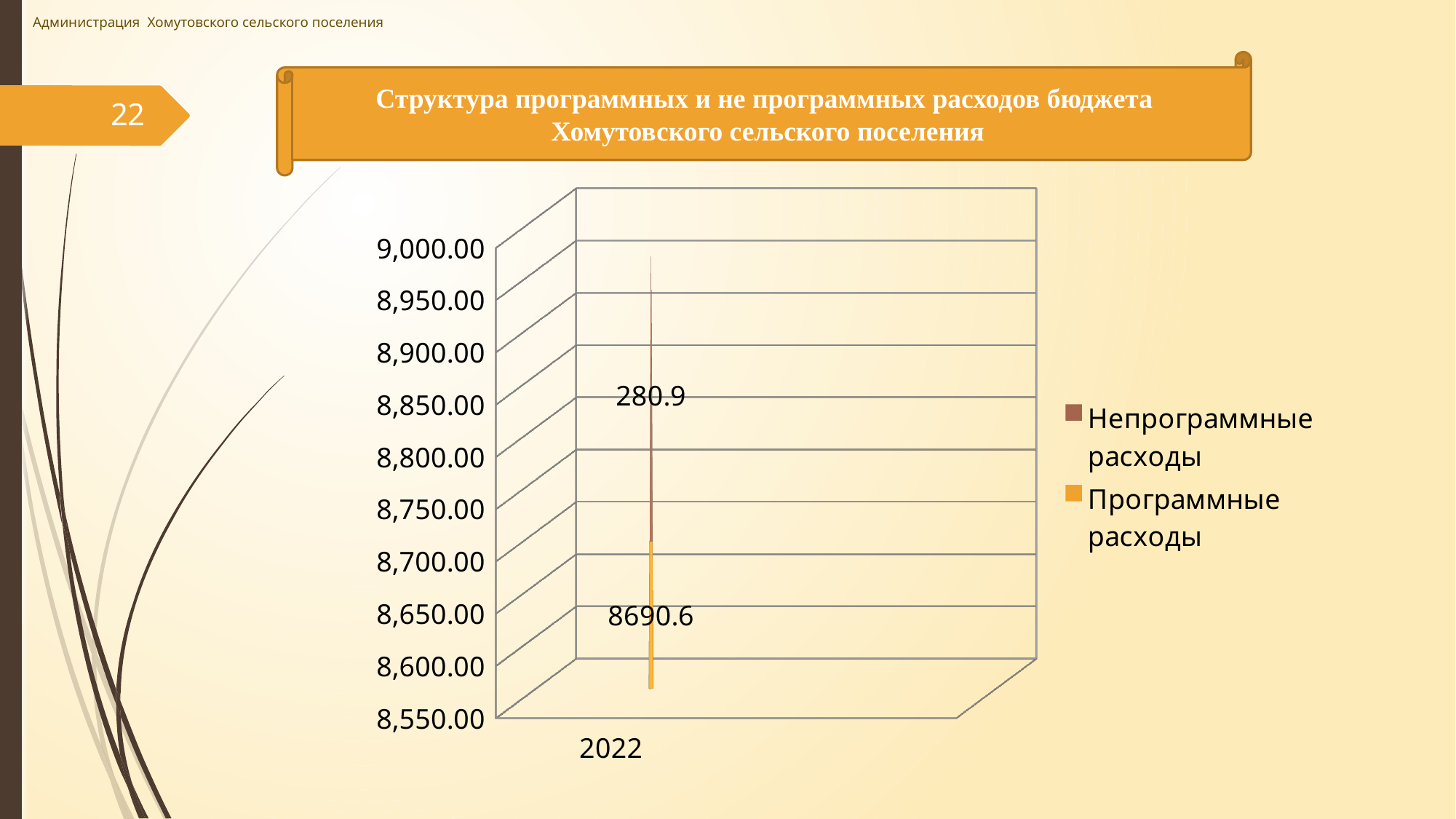
Which series has the smallest value shown on the chart? Непрограммные расходы What is the value of Программные расходы for 2022? 8690.6 What kind of chart is shown on the slide? Bar chart How many categories are shown on the x axis? 1 Which series has the larger value in 2022, Программные расходы or Непрограммные расходы? Программные расходы What is the difference between Программные расходы and Непрограммные расходы in 2022? 8409.7 Which year is shown on the x axis of the chart? 2022 How many series does the legend list? 2 Which series has the largest value shown on the chart? Программные расходы What is the total of the stacked bar for 2022? 8971.5 What is the value of Непрограммные расходы for 2022? 280.9 What colour represents Программные расходы in the legend? Orange